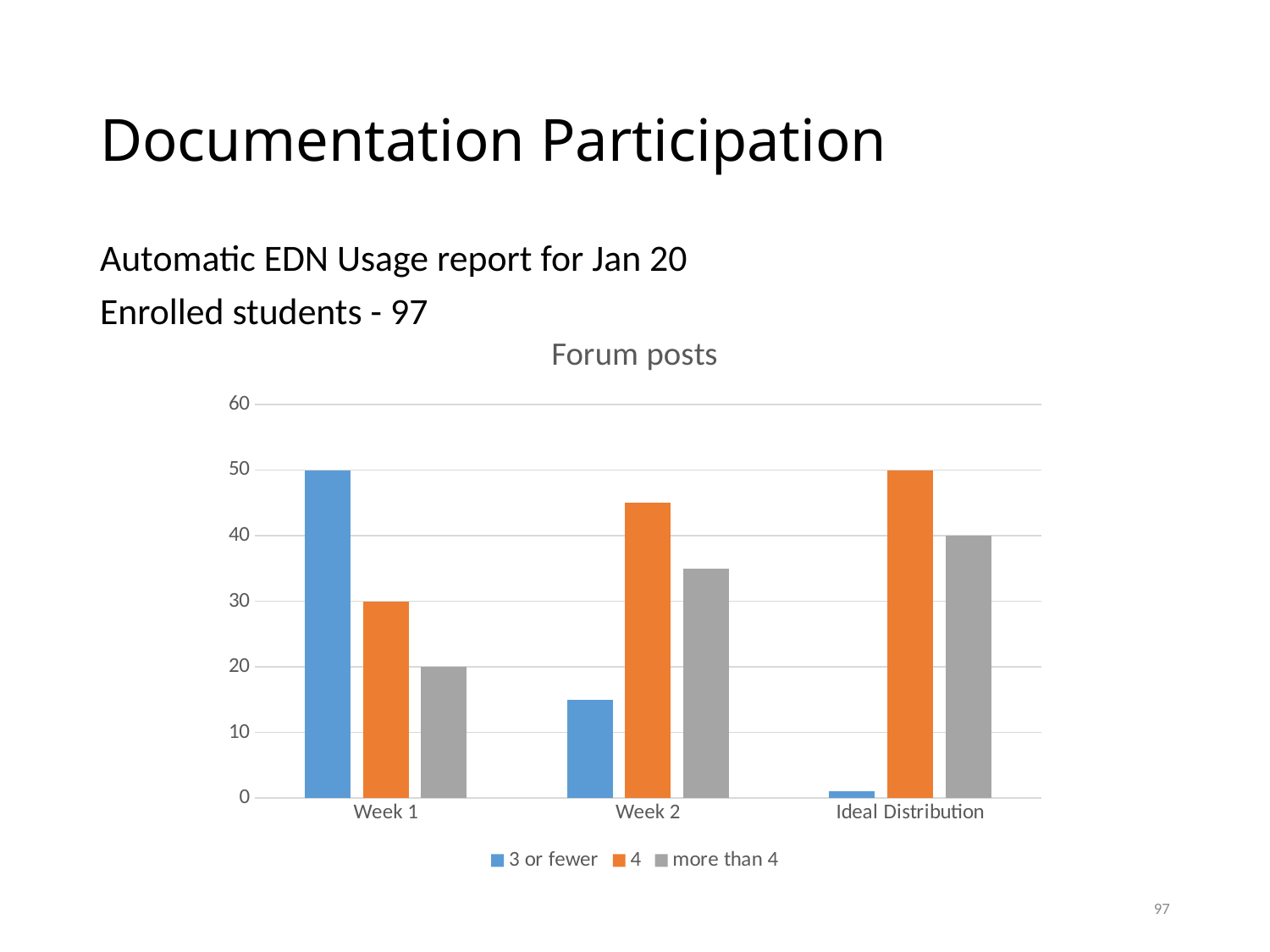
What is the value for 'more than 4' in Ideal Distribution? 40 What kind of chart is shown on the slide? bar chart How many categories are shown on the x axis? 3 Is the value for '3 or fewer' in Week 2 greater or less than 20? less What is the value for '4' in Ideal Distribution? 50 How many series does the legend list? 3 What is the title of the chart? Forum posts Is the value for '4' in Week 2 greater or less than 40? greater What is the value for '4' in Week 1? 30 What is the value for '3 or fewer' in Week 1? 50 Which series has the highest value in Week 1? 3 or fewer What is the value for 'more than 4' in Week 1? 20